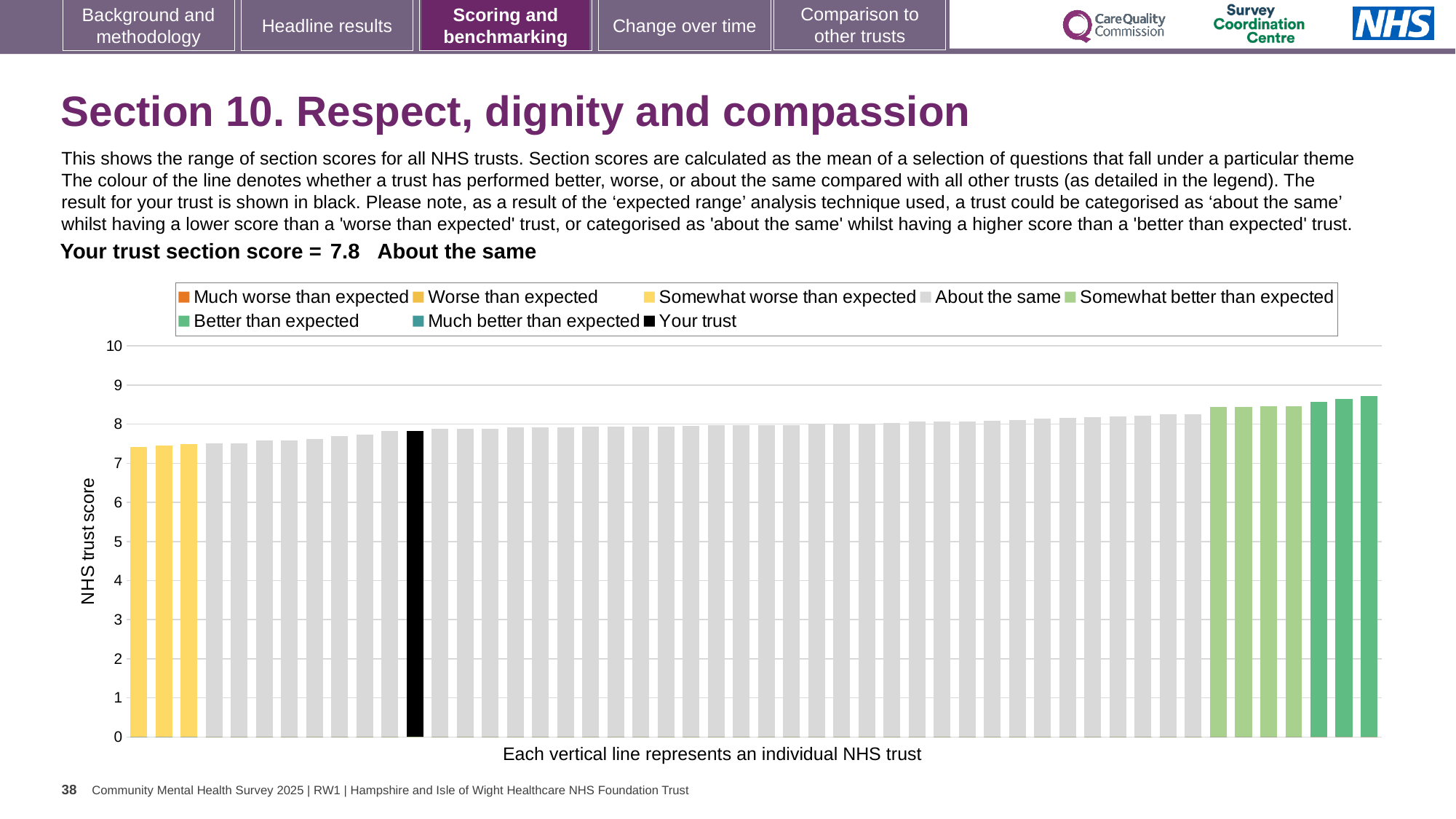
Do the bar values rise or fall from left to right along the x axis? rise Is the value of the tallest bar in the chart greater or less than 8? greater Is the value of the shortest bar in the chart greater or less than 8? less How many entries does the chart legend list? 8 Which legend category do the tallest bars on the right of the chart belong to? Better than expected How many bars are coloured as 'Somewhat better than expected' (light green)? 4 What kind of chart is shown on the slide? bar chart What is the label on the vertical axis of the chart? NHS trust score How many bars are coloured as 'Somewhat worse than expected' (yellow)? 3 Which category is your trust placed in for this section? About the same Is the value for your trust (the black bar) greater or less than 7? greater What is the section score for your trust shown on the slide? 7.8